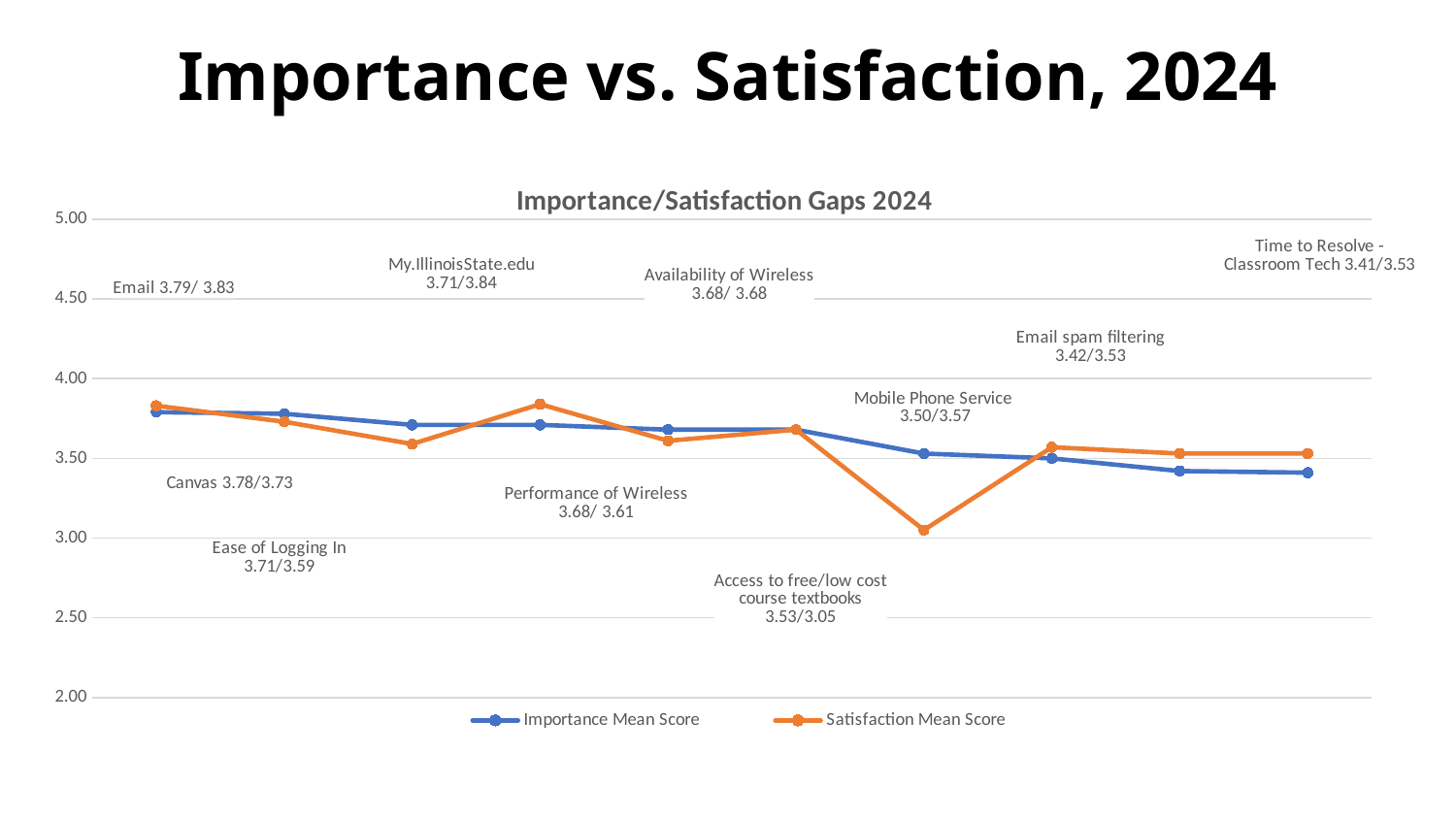
What is the difference between the Importance Mean Score and the Satisfaction Mean Score for Access to free/low cost course textbooks? 0.48 What is the Importance Mean Score for Email? 3.79 How many series does the legend list? 2 Which service has the lowest Satisfaction Mean Score? Access to free/low cost course textbooks What is the Satisfaction Mean Score for Email spam filtering? 3.53 How many services are plotted along the x axis? 10 For Mobile Phone Service, which is larger: the Importance Mean Score or the Satisfaction Mean Score? Satisfaction Mean Score Does the Importance Mean Score line generally rise or fall from left to right across the x axis? fall Which service has the highest Satisfaction Mean Score? My.IllinoisState.edu What is the Satisfaction Mean Score for Access to free/low cost course textbooks? 3.05 What kind of chart is shown on the slide? line chart What is the title printed above the chart area? Importance/Satisfaction Gaps 2024